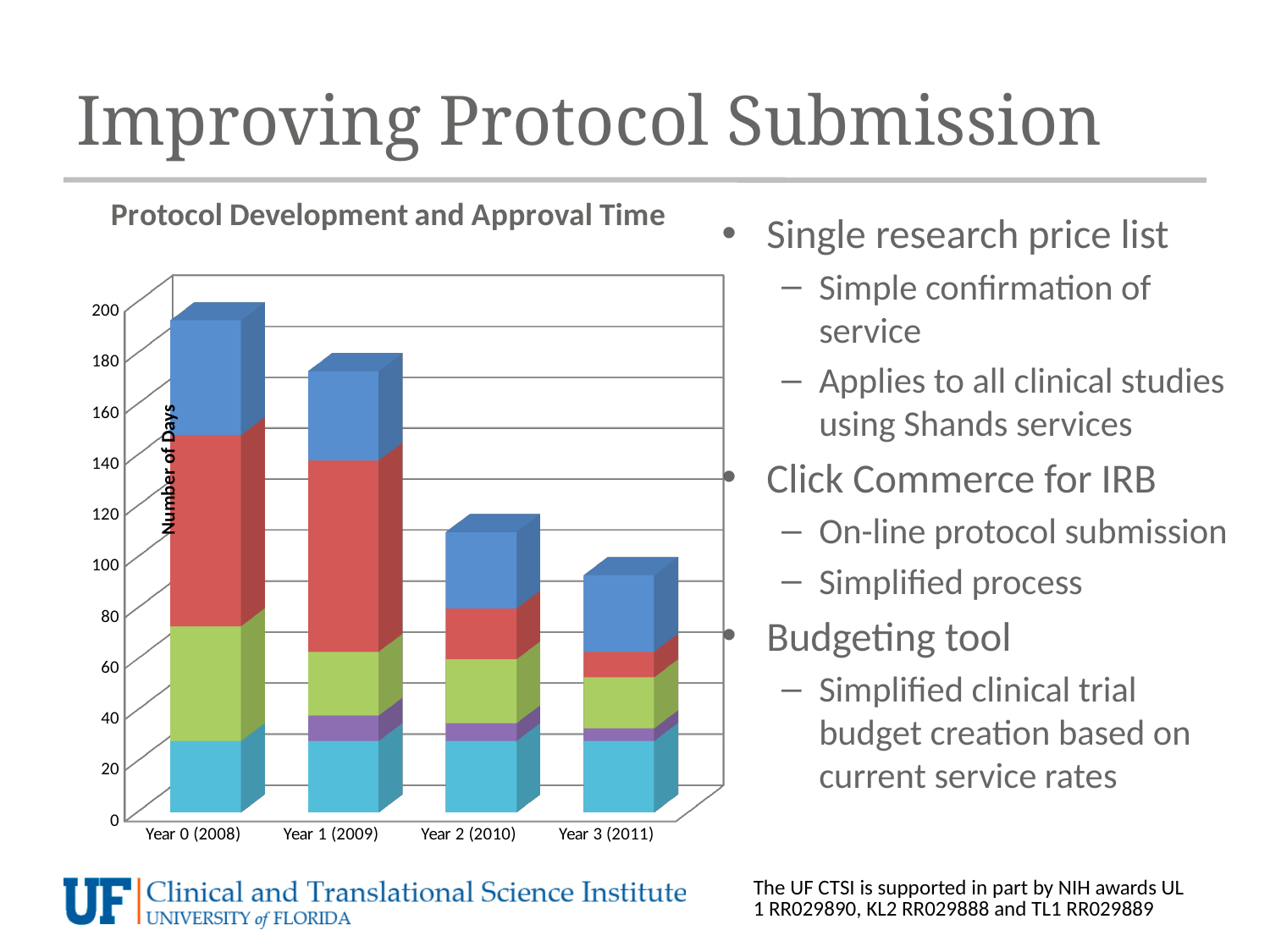
Is the total value for Year 0 (2008) greater or less than 160? greater What is the title of the chart? Protocol Development and Approval Time Do the total number of days rise or fall from Year 0 (2008) to Year 3 (2011)? Fall What type of chart is shown on the slide? Stacked bar chart Is the total value for Year 3 (2011) greater or less than 120? less Which year has the shortest stacked bar in the chart? Year 3 (2011) How many year categories are shown on the x axis of the chart? 4 Is the total value for Year 1 (2009) greater or less than 140? greater What is the label on the vertical axis of the chart? Number of Days Which stacked bar is taller, Year 1 (2009) or Year 2 (2010)? Year 1 (2009) Which year has the tallest stacked bar in the chart? Year 0 (2008)